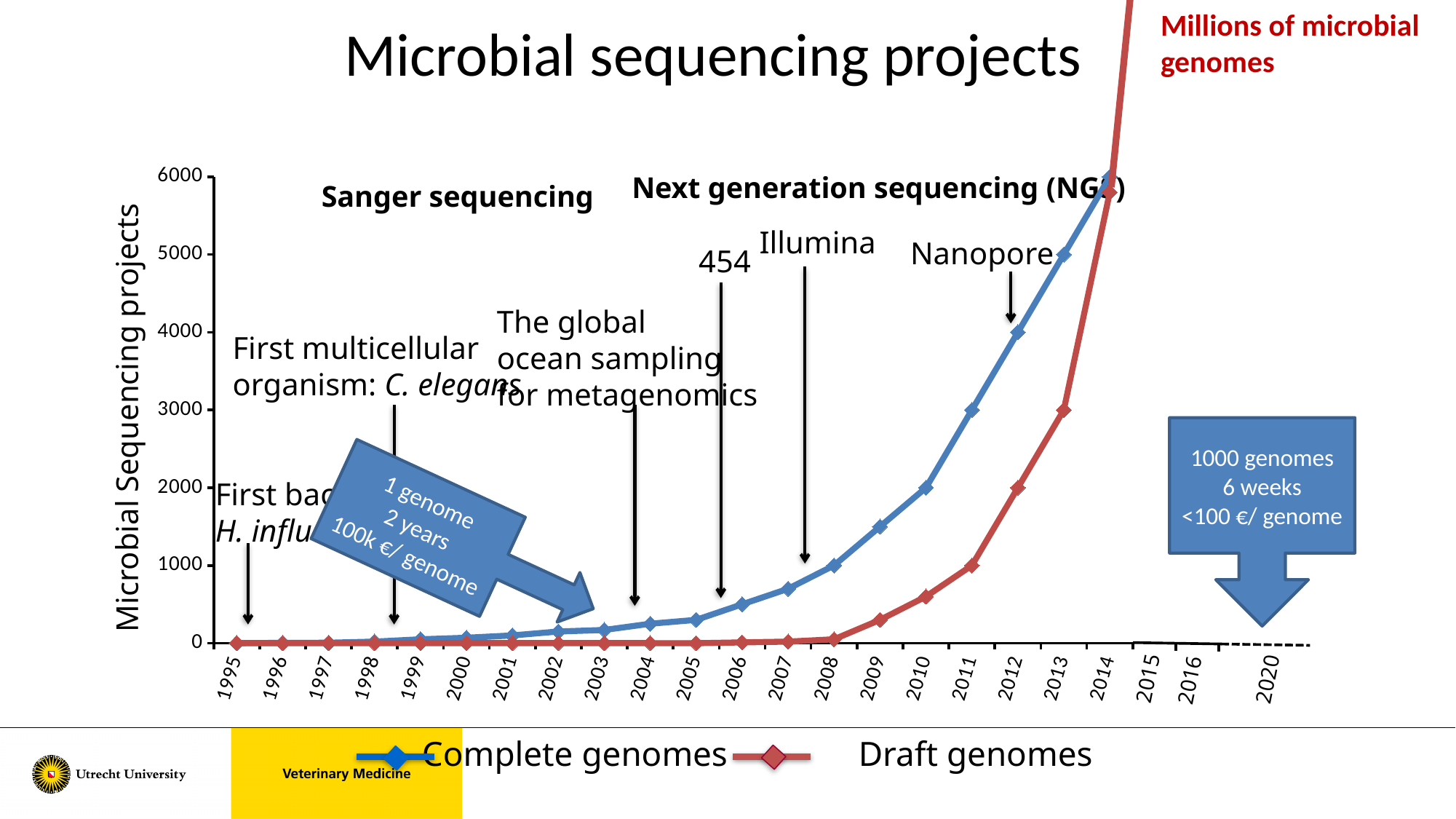
Is the value for Complete genomes in 2009 greater or less than 1000? greater Is the value for Draft genomes in 2010 greater or less than 1000? less In which year shown does the Complete genomes series reach its highest value? 2014 How many series does the legend list? 2 What kind of chart is shown on the slide? line chart What is the value for Complete genomes in 2012? 4000 What are the two series named in the legend? Complete genomes and Draft genomes Which series has the larger value in 2012, Complete genomes or Draft genomes? Complete genomes What is the value for Complete genomes in 2013? 5000 What is the label on the vertical axis? Microbial Sequencing projects What is the value for Draft genomes in 2013? 3000 Do the values for Complete genomes rise or fall from 1995 to 2014? rise